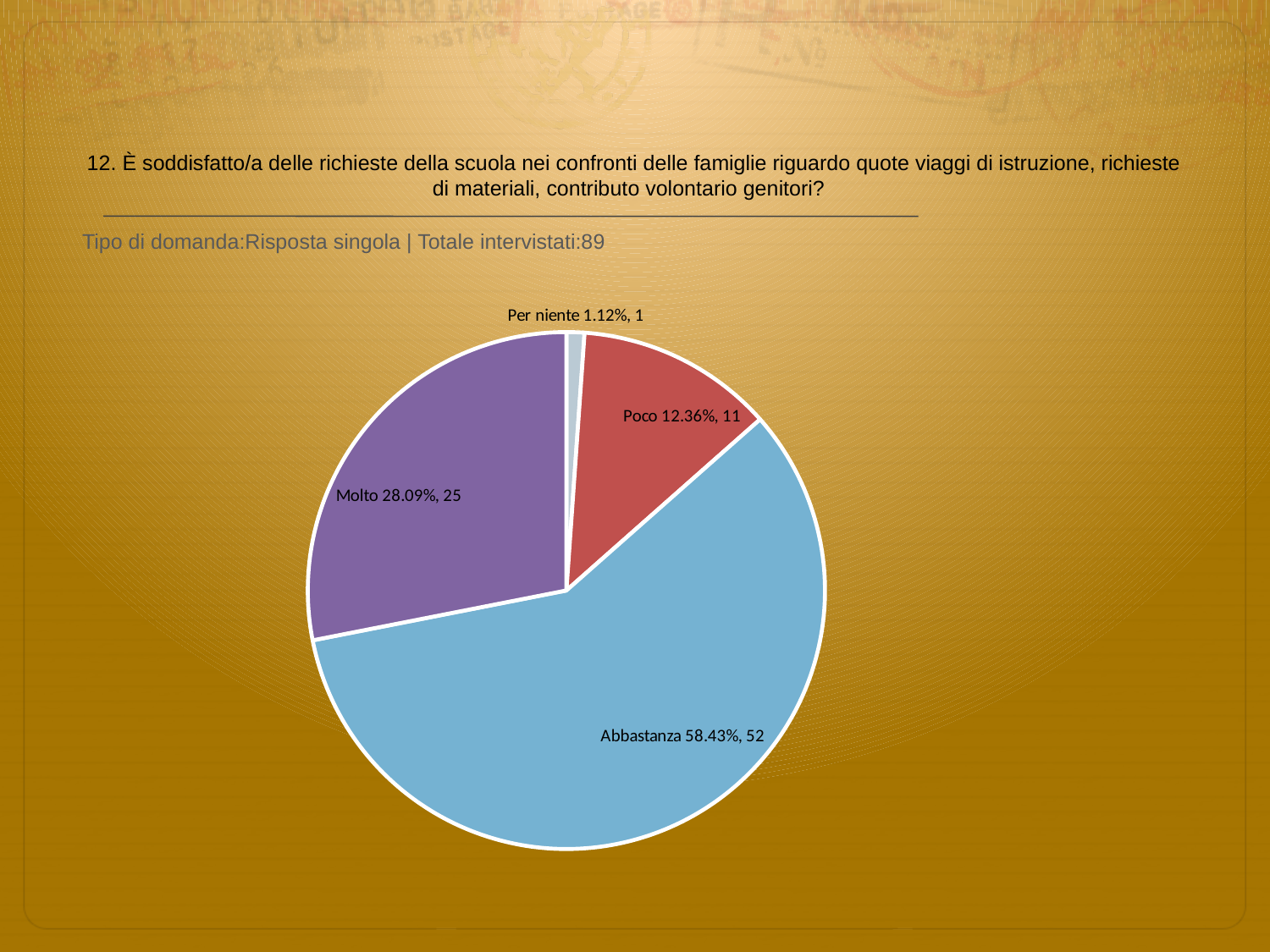
What percentage share does the 'Abbastanza' slice have? 58.43% What kind of chart is shown on the slide? pie chart How many respondents answered 'Molto'? 25 How many respondents answered 'Poco'? 11 What colour is the 'Molto' slice? purple How many slices does the pie chart have? 4 Which has more respondents, 'Molto' or 'Poco'? Molto What is the total number of respondents across all slices? 89 Which category has the smallest slice? Per niente Which category has the largest slice? Abbastanza What is the difference in respondent count between 'Abbastanza' and 'Molto'? 27 What percentage share does the 'Per niente' slice have? 1.12%